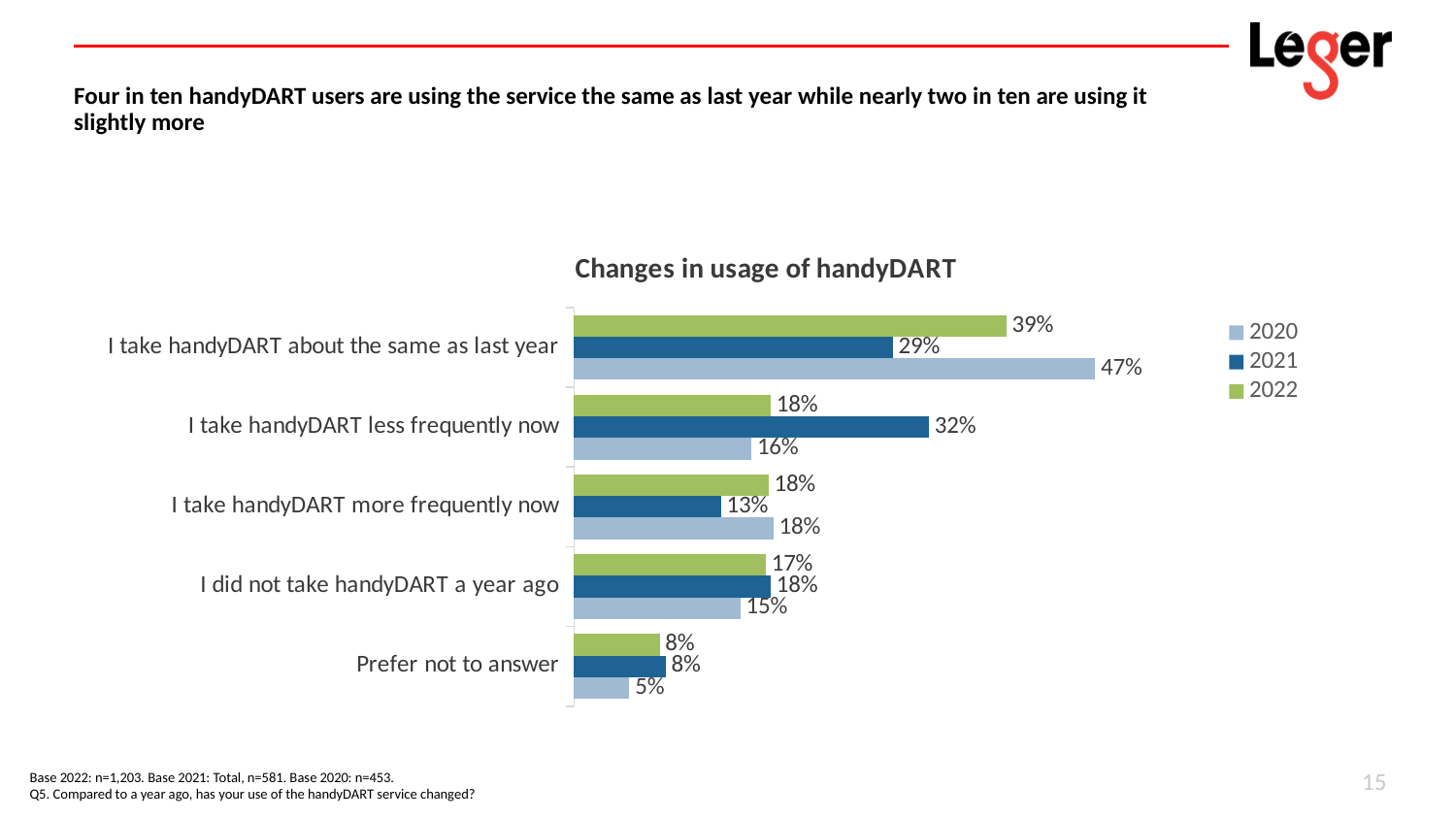
What is the 2022 value for 'I take handyDART about the same as last year'? 39% What is the difference between the 2020 and 2022 values for 'I take handyDART about the same as last year'? 8% How many categories are shown in the chart? 5 What is the 2020 value for 'Prefer not to answer'? 5% What is the 2021 value for 'I take handyDART less frequently now'? 32% Which category has the highest 2020 value? I take handyDART about the same as last year What kind of chart is shown on the slide? Bar chart What is the title of the chart? Changes in usage of handyDART How many series does the legend list? 3 What is the 2021 value for 'I take handyDART more frequently now'? 13% Which category has the lowest 2022 value? Prefer not to answer Which is larger for 'I take handyDART less frequently now': the 2021 value or the 2022 value? 2021